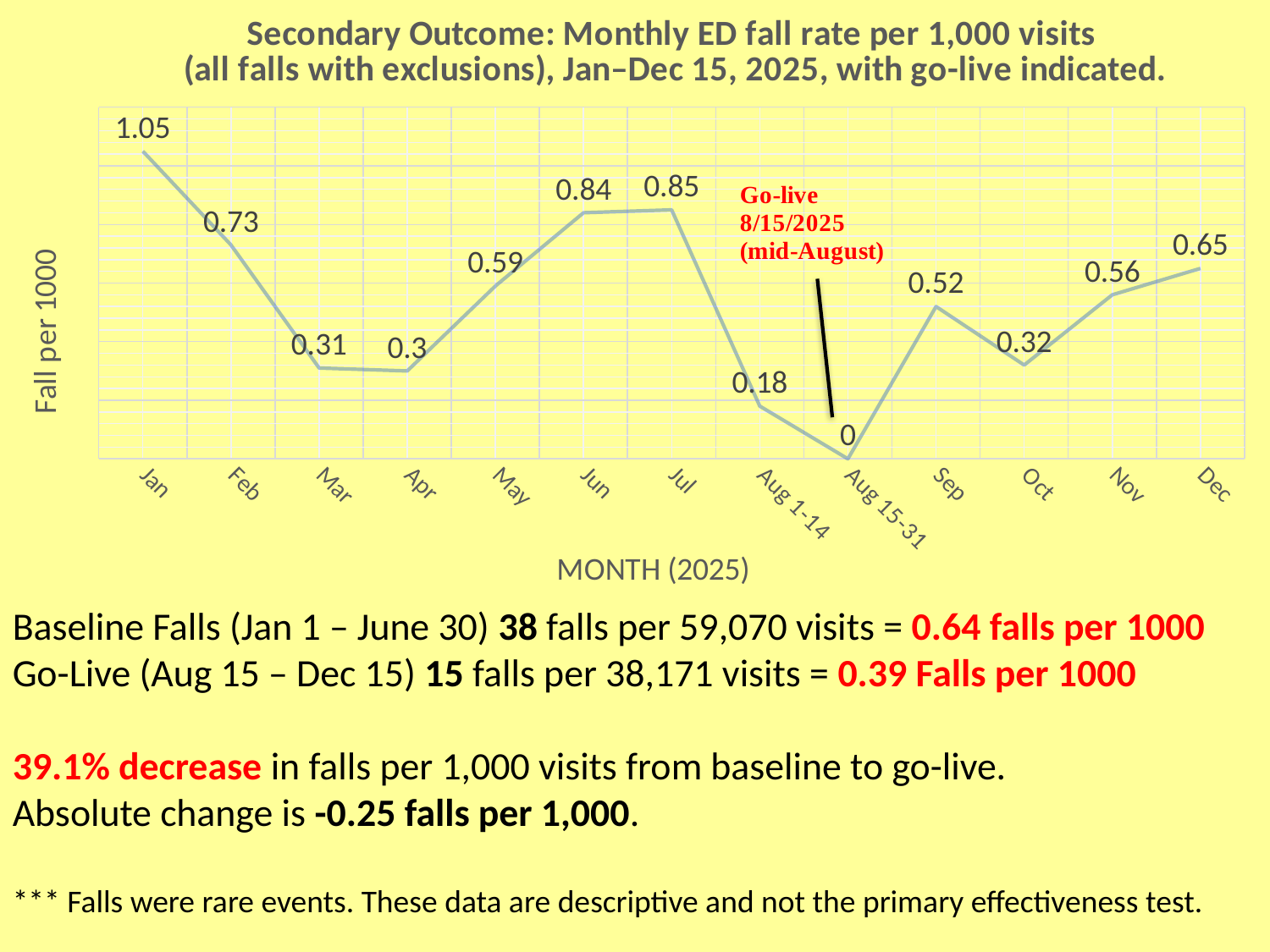
What is the fall rate per 1000 for Sep? 0.52 What is the fall rate per 1000 for Jan? 1.05 What is the difference between the fall rate for Jan and the fall rate for Feb? 0.32 What kind of chart is shown on the slide? line chart What is the fall rate per 1000 for Aug 1-14? 0.18 Which month has the highest fall rate per 1000? Jan What is the label on the x axis of the chart? MONTH (2025) Which period has the lowest fall rate per 1000? Aug 15-31 How many data points are plotted on the chart? 13 Does the fall rate rise or fall from Aug 15-31 to Sep? rise Which has a higher fall rate per 1000, Jun or Oct? Jun What is the fall rate per 1000 for Dec? 0.65